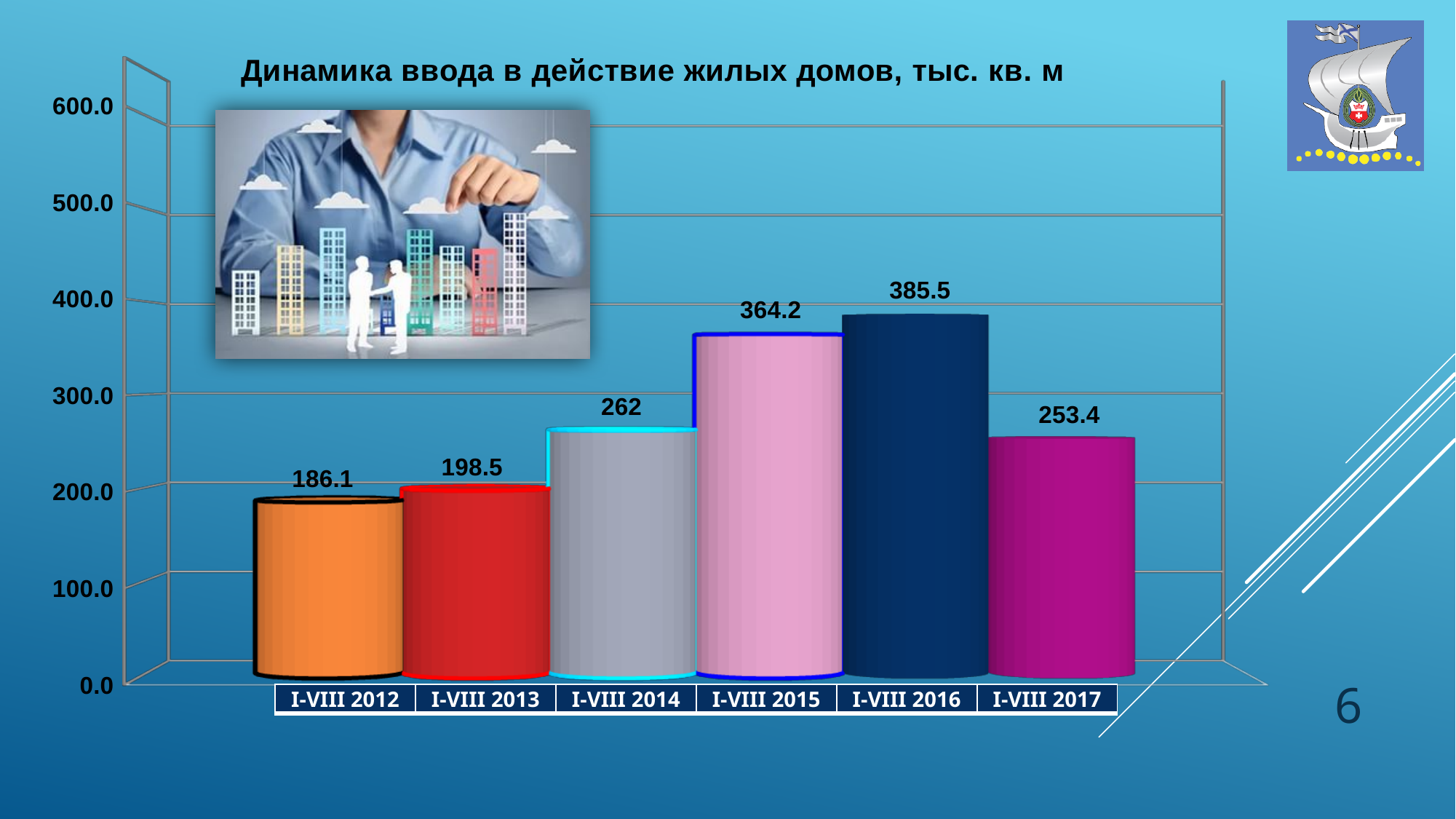
What is the value for I-VIII 2012? 186.1 What is the value for I-VIII 2015? 364.2 What kind of chart is shown on the slide? bar chart Is the value for I-VIII 2016 greater or less than 400.0? less How many periods are shown on the chart? 6 Which period has the highest value? I-VIII 2016 Which is larger, the value for I-VIII 2014 or the value for I-VIII 2017? I-VIII 2017 What is the title of the chart? Динамика ввода в действие жилых домов, тыс. кв. м Which period has the lowest value? I-VIII 2012 What is the difference between the values for I-VIII 2014 and I-VIII 2013? 63.5 What is the value for I-VIII 2017? 253.4 What is the difference between the values for I-VIII 2016 and I-VIII 2015? 21.3